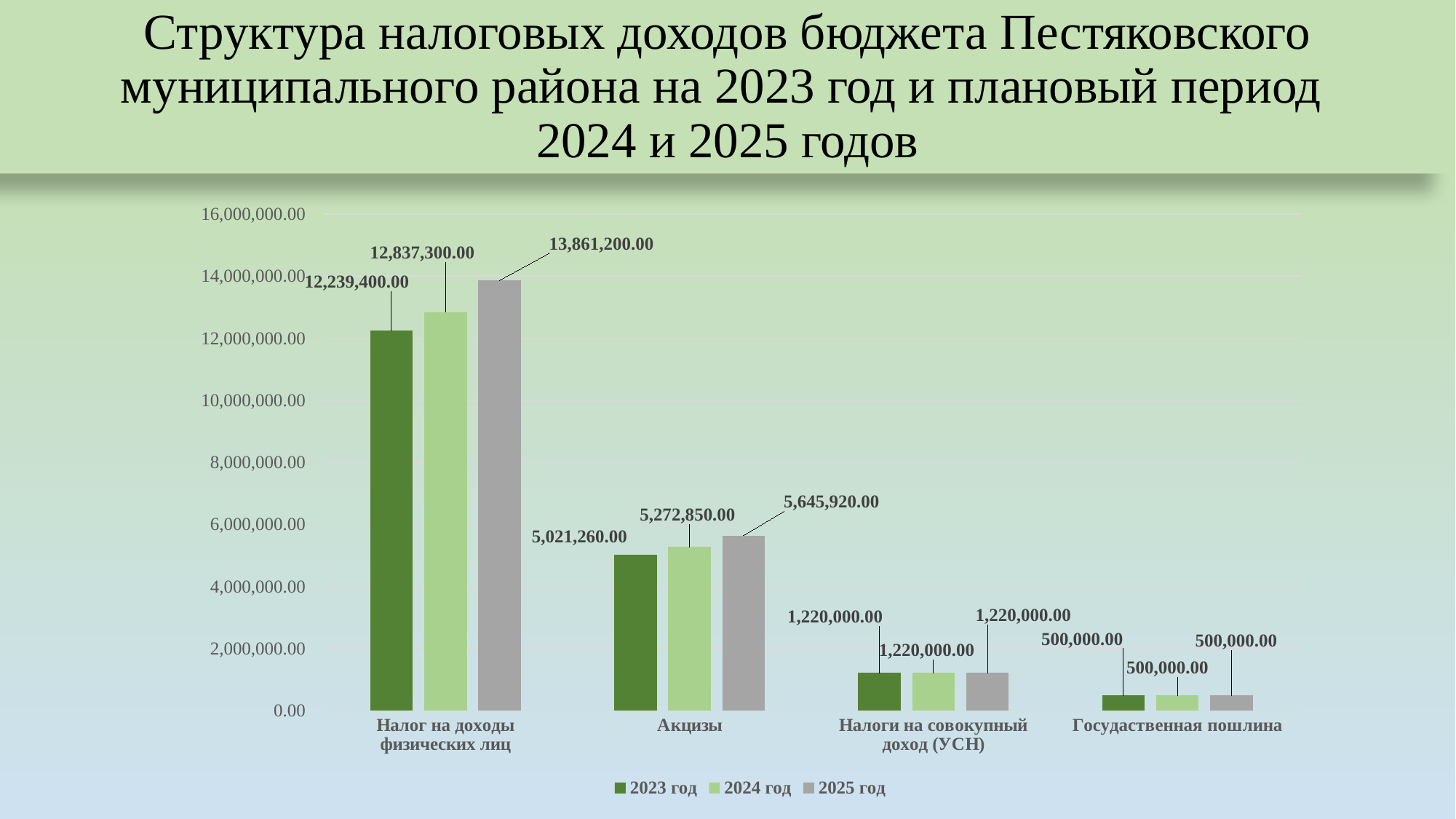
How many categories are shown on the x axis? 4 What is the value for Акцизы in the 2025 год series? 5,645,920.00 What is the value for Налоги на совокупный доход (УСН) in the 2024 год series? 1,220,000.00 How many series does the legend list? 3 What kind of chart is shown on the slide? Bar chart Which is larger for Акцизы: the 2024 год value or the 2025 год value? 2025 год What is the value for Государственная пошлина in the 2025 год series? 500,000.00 What is the value for Налог на доходы физических лиц in the 2023 год series? 12,239,400.00 Which category has the lowest value in the 2023 год series? Государственная пошлина What is the difference between the 2025 год and 2023 год values for Налог на доходы физических лиц? 1,621,800.00 What is the difference between the 2025 год and 2023 год values for Акцизы? 624,660.00 Which category has the highest value in the 2025 год series? Налог на доходы физических лиц